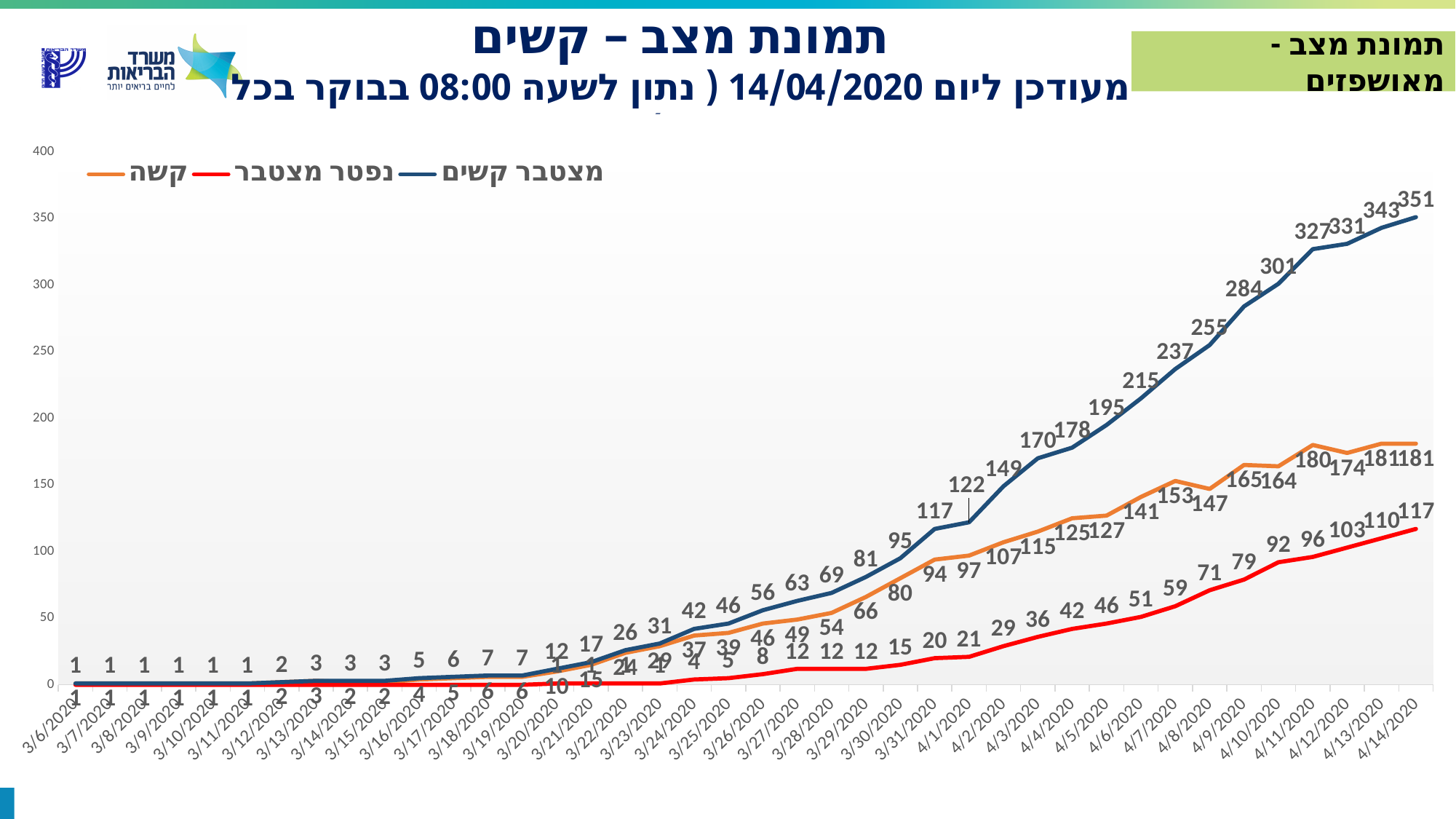
What colour is the line for the נפטר מצטבר series? red Is the value of the מצטבר קשים series on 4/14/2020 greater or less than 300? greater On which date does the מצטבר קשים series reach its highest value? 4/14/2020 On 4/14/2020, which is larger: the קשה value or the נפטר מצטבר value? קשה What is the value of the קשה series on 4/11/2020? 180 How many series does the chart legend list? 3 What is the difference between the מצטבר קשים value and the נפטר מצטבר value on 4/14/2020? 234 What is the value of the מצטבר קשים series on 4/1/2020? 122 Does the מצטבר קשים series rise or fall from 3/6/2020 to 4/14/2020? rise What is the value of the מצטבר קשים series on 4/14/2020? 351 What is the value of the נפטר מצטבר series on 4/14/2020? 117 What kind of chart is shown on the slide? line chart